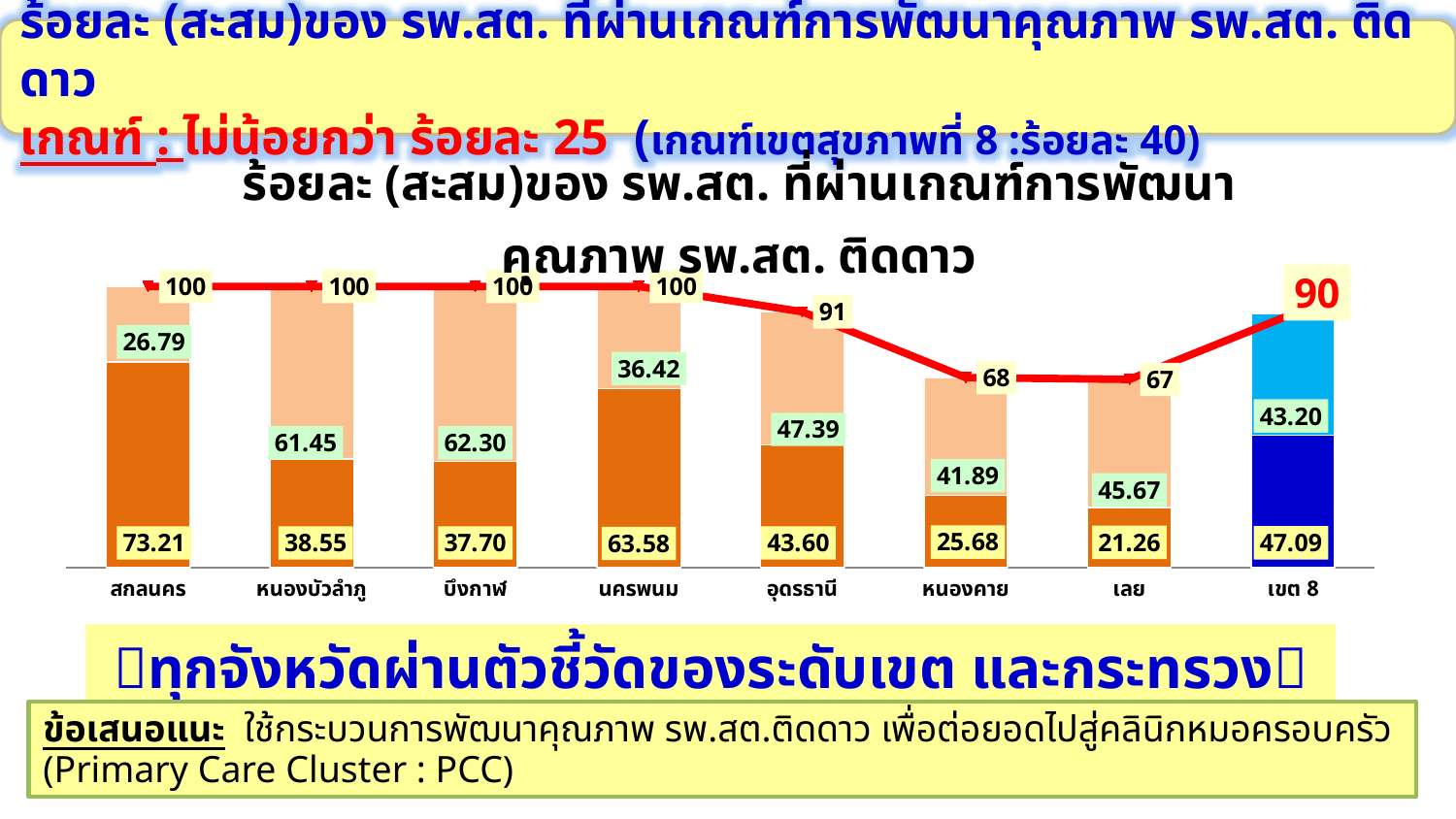
What is the value of the bottom (dark orange) segment for สกลนคร? 73.21 What value does the red line show for เขต 8? 90 Which category has the highest bottom-segment value? สกลนคร What is the value of the top (light orange) segment for บึงกาฬ? 62.30 Which has a larger bottom-segment value, หนองคาย or เลย? หนองคาย What value does the red line show for อุดรธานี? 91 What kind of chart is this? Stacked bar chart with a line Which category has the lowest bottom-segment value? เลย What is the difference between the bottom-segment values of สกลนคร and นครพนม? 9.63 How many categories are shown on the x axis? 8 Does the red line rise or fall from นครพนม to เลย? Fall What is the total of the two stacked segments for หนองคาย? 67.57